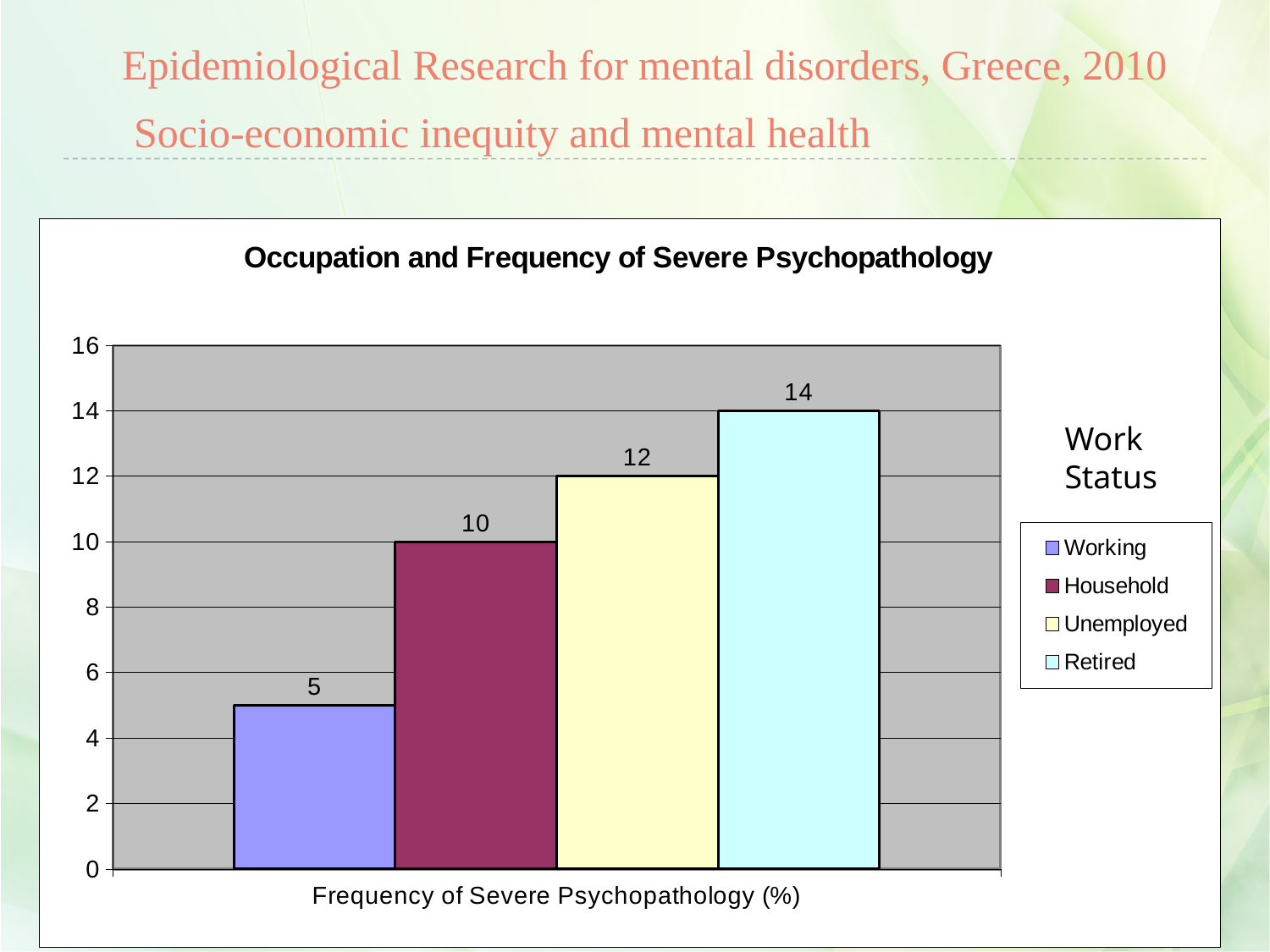
What kind of chart is shown on the slide? Bar chart Which work status has the lowest frequency of severe psychopathology? Working What is the value for Household? 10 Which is larger, the value for Household or the value for Unemployed? Unemployed What is the value for Working? 5 What is the difference between the values for Retired and Working? 9 What is the title of the chart? Occupation and Frequency of Severe Psychopathology Which work status has the highest frequency of severe psychopathology? Retired What is the value for Retired? 14 How many entries does the legend list? 4 What is the value for Unemployed? 12 How many bars are shown in the chart? 4